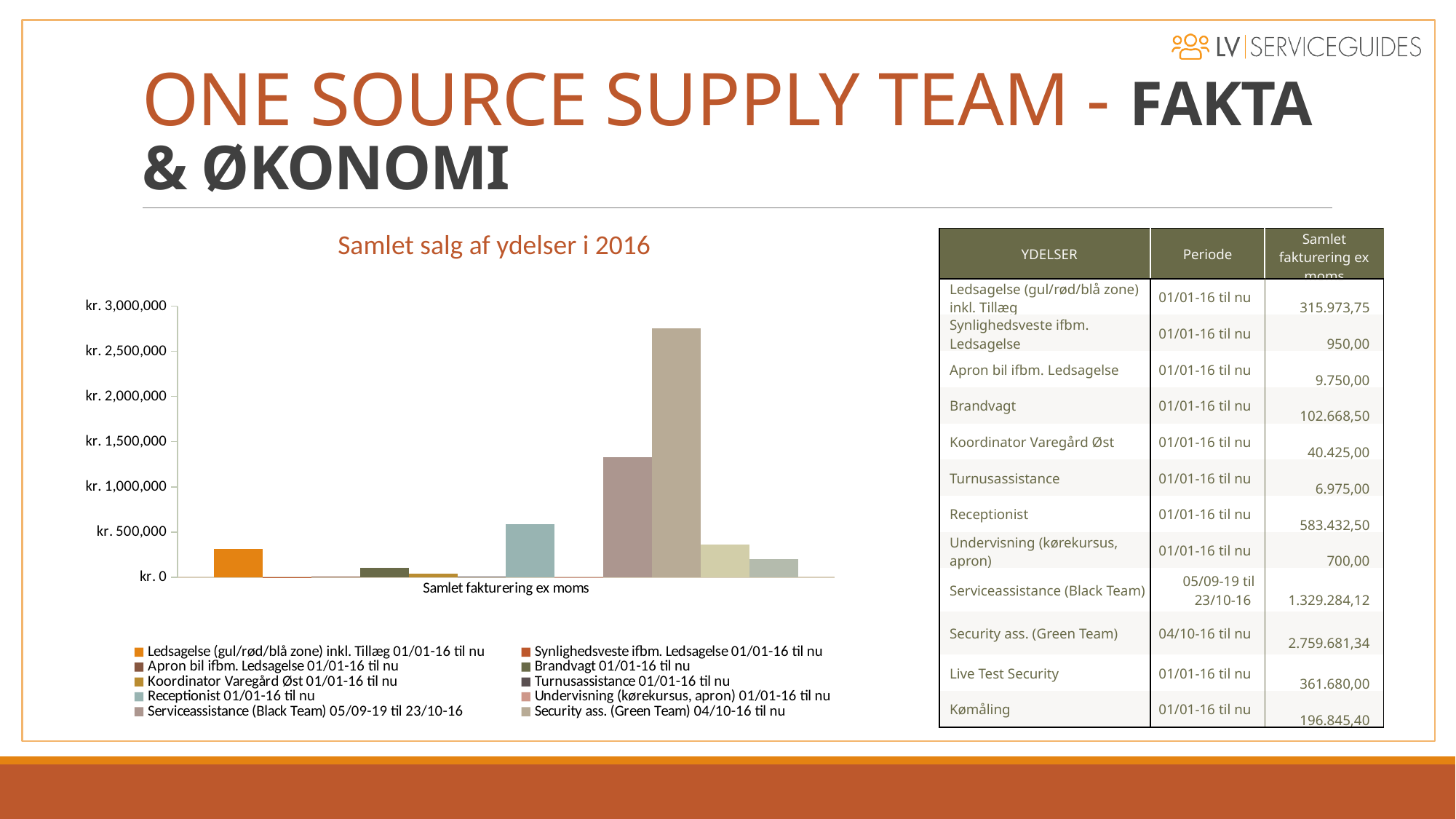
Is the value for Ledsagelse (gul/rød/blå zone) inkl. Tillæg greater or less than kr. 500,000? less What is the title of the chart on the slide? Samlet salg af ydelser i 2016 Is the value for Security ass. (Green Team) greater or less than kr. 2,500,000? greater Is the value for Serviceassistance (Black Team) greater or less than kr. 1,000,000? greater Which is larger in the chart, Serviceassistance (Black Team) or Receptionist? Serviceassistance (Black Team) What kind of chart is shown under the title 'Samlet salg af ydelser i 2016'? bar chart Which series has the tallest bar in the chart? Security ass. (Green Team) 04/10-16 til nu What label is shown on the x axis of the chart? Samlet fakturering ex moms Which is larger in the chart, Ledsagelse (gul/rød/blå zone) inkl. Tillæg or Brandvagt? Ledsagelse (gul/rød/blå zone) inkl. Tillæg How many series does the chart legend list? 10